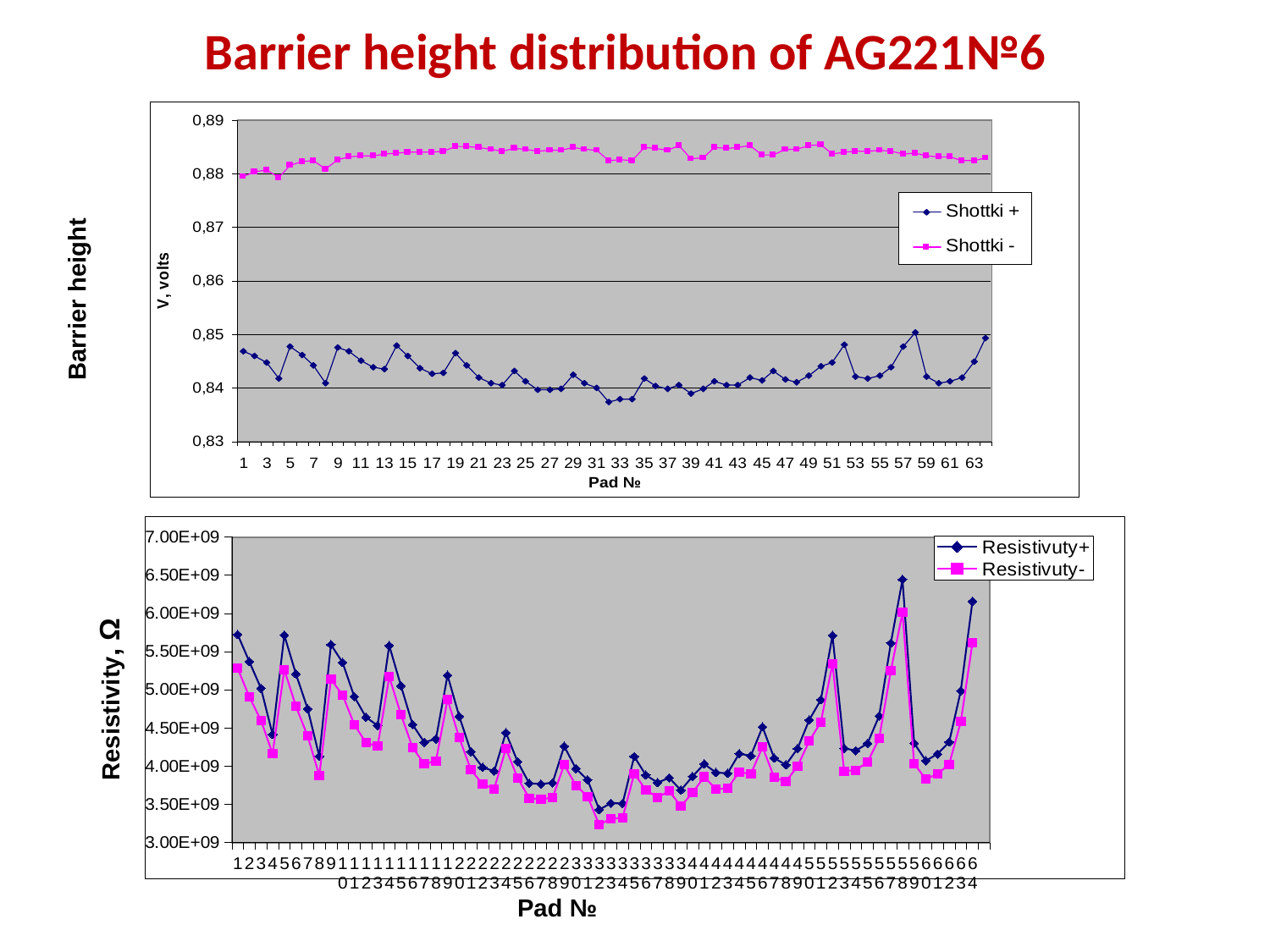
In the bottom chart (Resistivity), is the Resistivuty+ value at pad 1 greater or less than 5.50E+09? greater In the top chart (Barrier height), is the Shottki + value at pad 1 greater or less than 0,85? less What is the y-axis label of the bottom chart? Resistivity, Ω What are the two legend entries of the top chart (Barrier height)? Shottki + and Shottki - In the top chart (Barrier height), is the Shottki - value at pad 1 greater or less than 0,87? greater In the top chart (Barrier height), which series has the larger value at pad 1, Shottki + or Shottki -? Shottki - In the bottom chart (Resistivity), which series has the larger value at pad 58, Resistivuty+ or Resistivuty-? Resistivuty+ How many series does the legend of the bottom chart (Resistivity) list? 2 How many series does the legend of the top chart (Barrier height) list? 2 What kind of chart is the top chart (Barrier height)? line chart